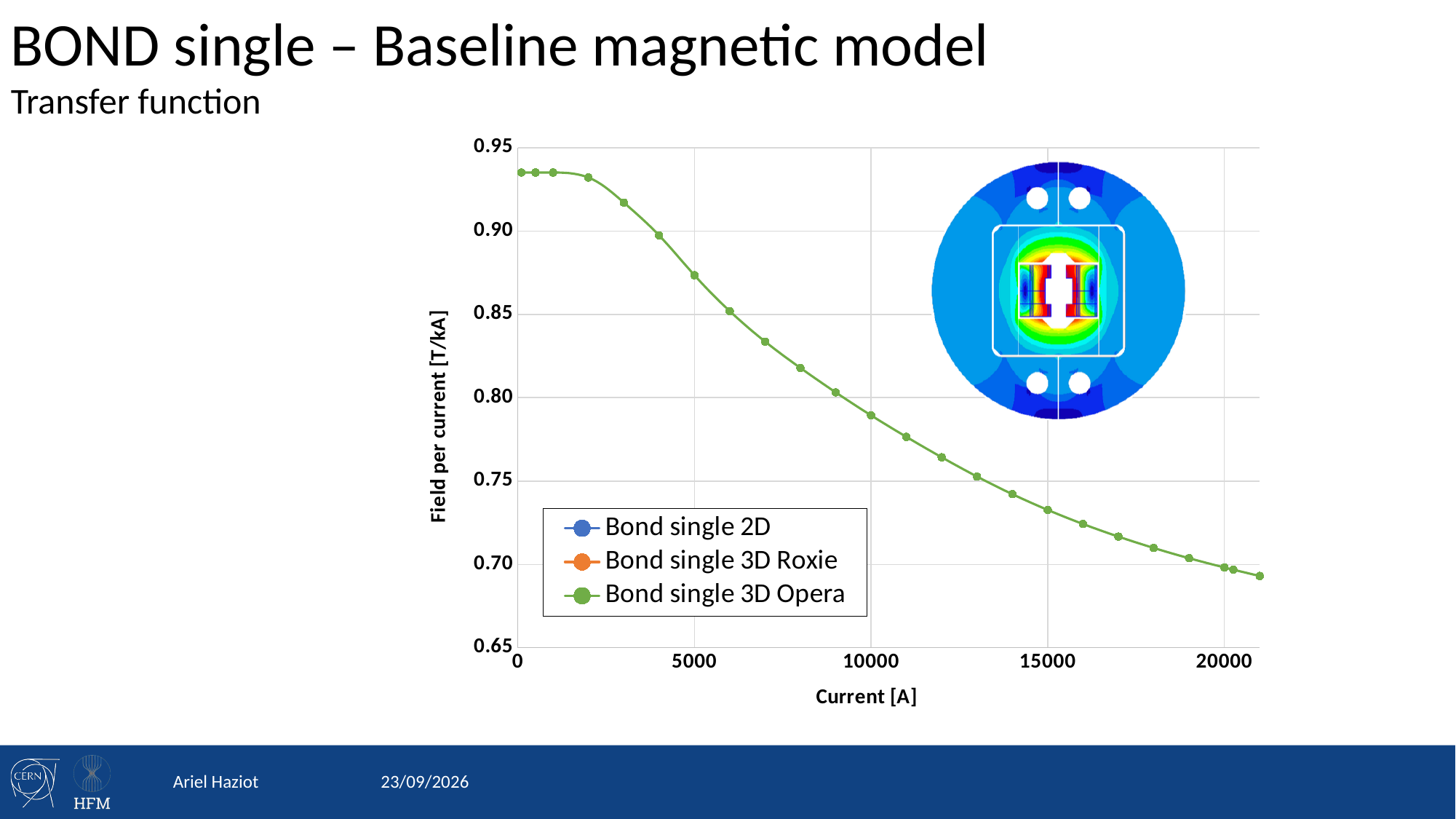
What is the label of the y axis? Field per current [T/kA] Is the field per current at 5000 A greater or less than 0.85 T/kA? greater Which is larger, the field per current at 5000 A or at 15000 A? 5000 A Does the field per current rise or fall as the current increases along the x axis? fall How many series does the legend list? 3 Is the field per current at 10000 A greater or less than 0.80 T/kA? less What kind of chart is shown on the slide? line chart Is the field per current at 20000 A greater or less than 0.75 T/kA? less What is the label of the x axis? Current [A]